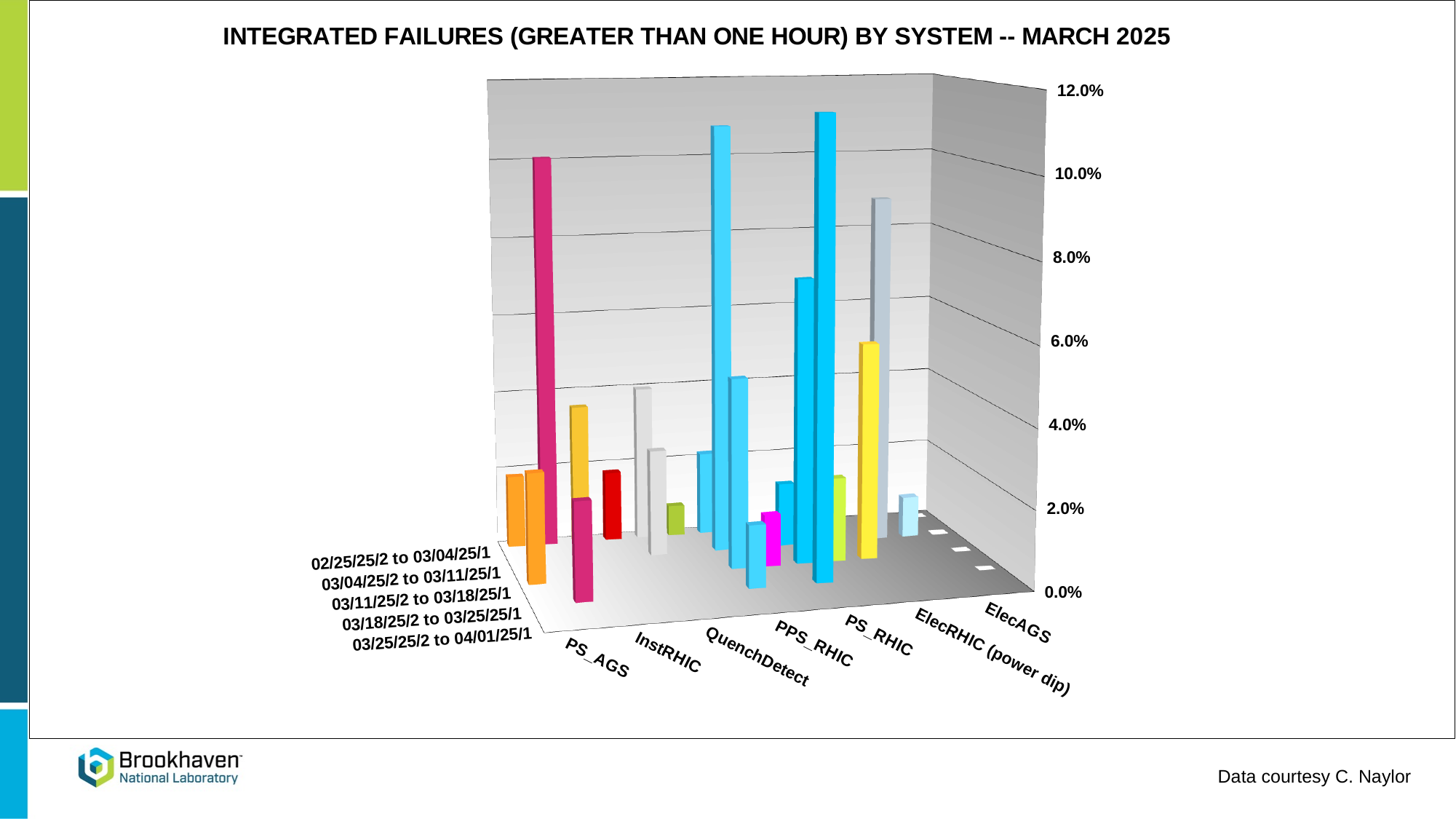
What is the highest tick value shown on the vertical axis? 12.0% What is the title of the chart? INTEGRATED FAILURES (GREATER THAN ONE HOUR) BY SYSTEM -- MARCH 2025 How many weekly time periods are shown along the depth axis of the chart? 5 What kind of chart is shown on the slide? bar chart Is the tallest value for PS_AGS greater or less than 6.0%? less Is the tallest value for InstRHIC greater or less than 8.0%? less Is the tallest value for PPS_RHIC greater or less than 8.0%? greater Which system has the tallest bar in the chart? PS_RHIC How many systems are listed along the horizontal axis of the chart? 7